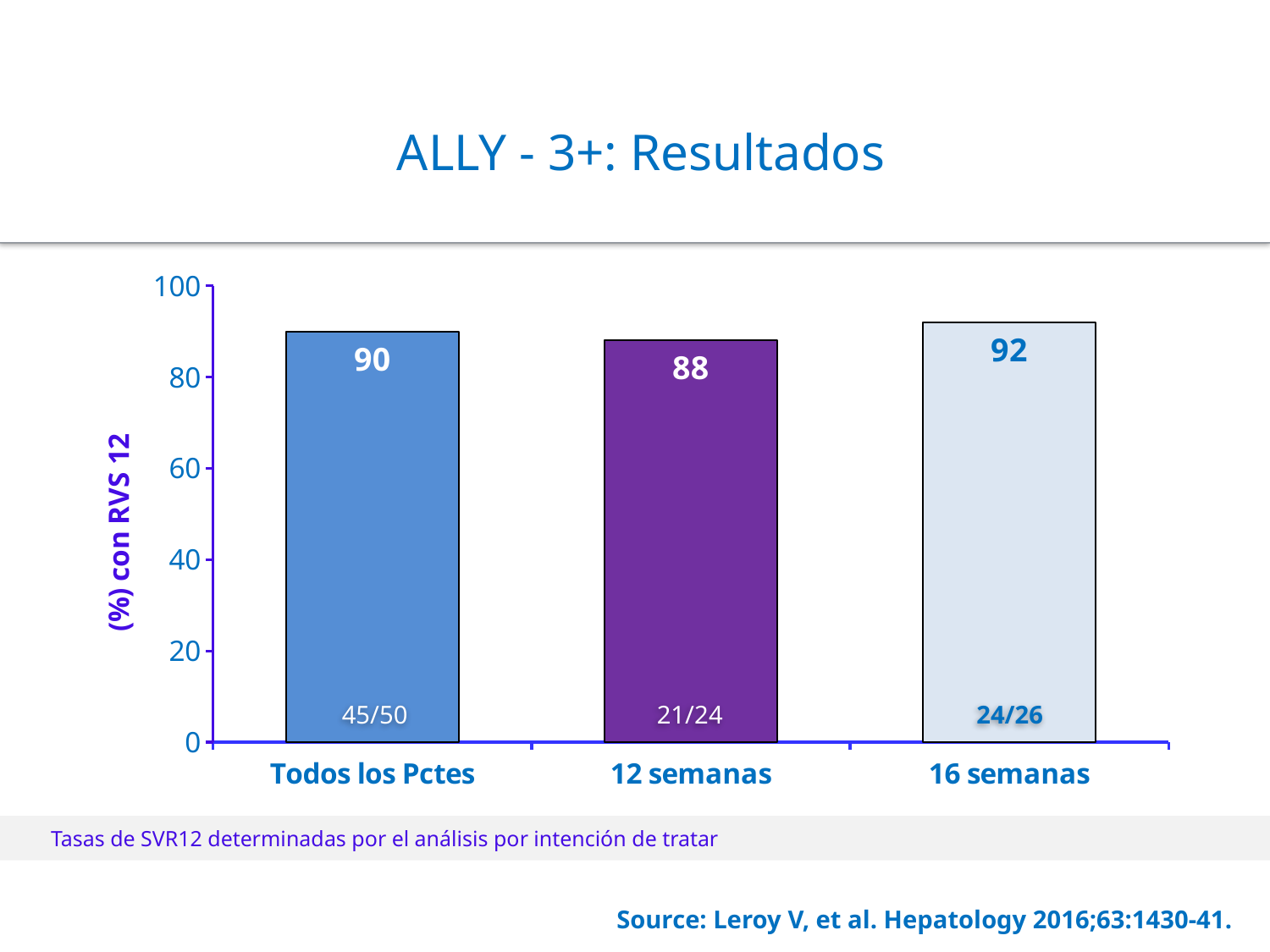
What is the difference in SVR12 rate between 16 semanas and 12 semanas? 4 What is the SVR12 rate (%) for 12 semanas? 88 What kind of chart is shown on the slide? Bar chart How many categories are shown on the x axis? 3 What fraction of patients is shown inside the bar for Todos los Pctes? 45/50 Which has a higher SVR12 rate, Todos los Pctes or 12 semanas? Todos los Pctes Which category has the highest SVR12 rate? 16 semanas Which category has the lowest SVR12 rate? 12 semanas What is the SVR12 rate (%) for 16 semanas? 92 What is the title of the chart on the slide? ALLY - 3+: Resultados What fraction of patients is shown inside the bar for 16 semanas? 24/26 What is the SVR12 rate (%) for Todos los Pctes? 90